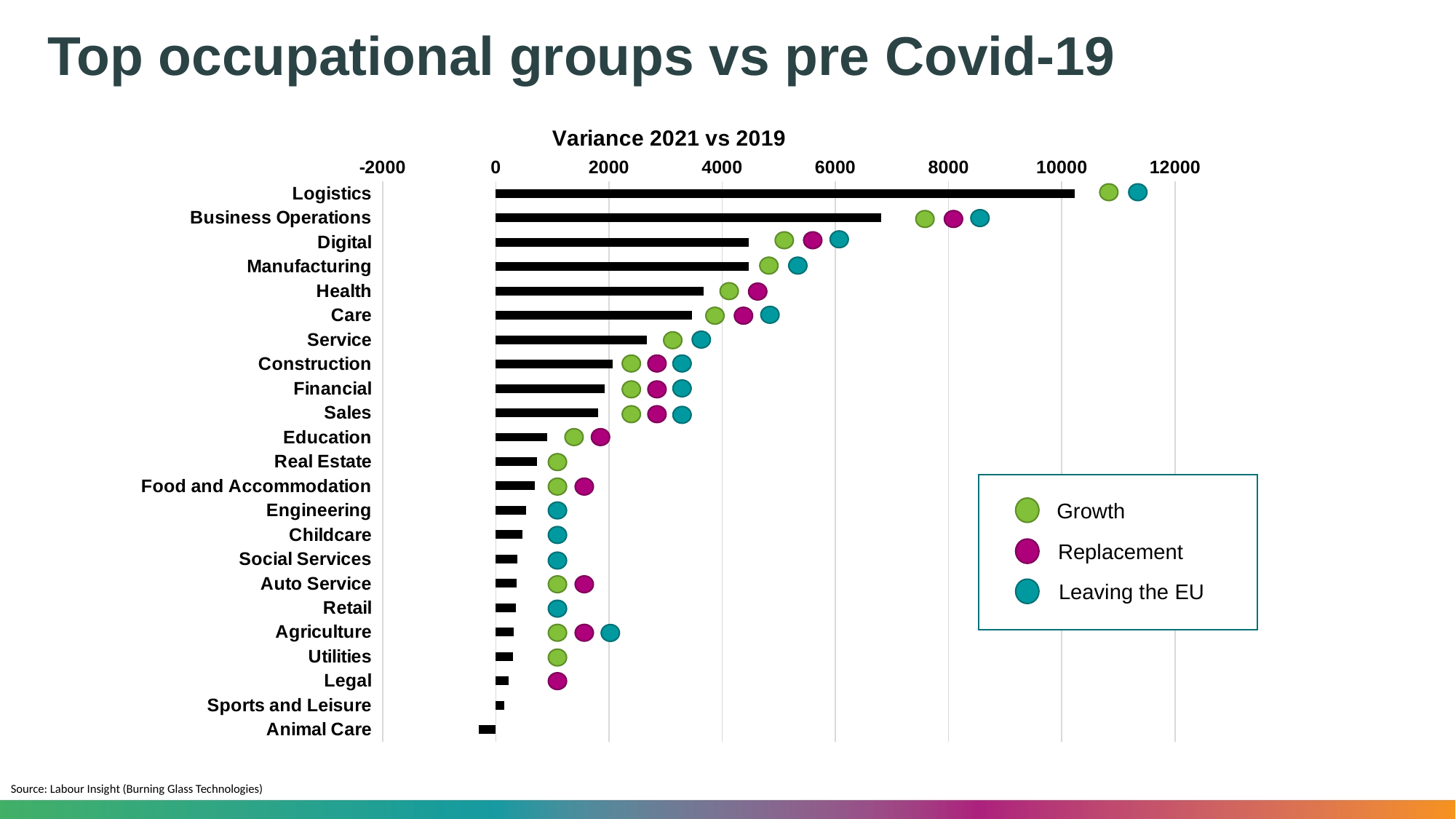
Which occupational group has the highest variance bar? Logistics What are the three entries in the chart's legend? Growth, Replacement, Leaving the EU How many entries does the chart's legend list? 3 How many occupational groups are listed on the chart? 23 What kind of chart is shown on the slide? bar chart Is the variance bar for Business Operations greater or less than 6000? greater Which has the larger variance bar, Service or Education? Service What is the title of the chart? Variance 2021 vs 2019 Which occupational group has the lowest variance bar? Animal Care Is the variance bar for Logistics greater or less than 8000? greater Is the variance bar for Health greater or less than 4000? less